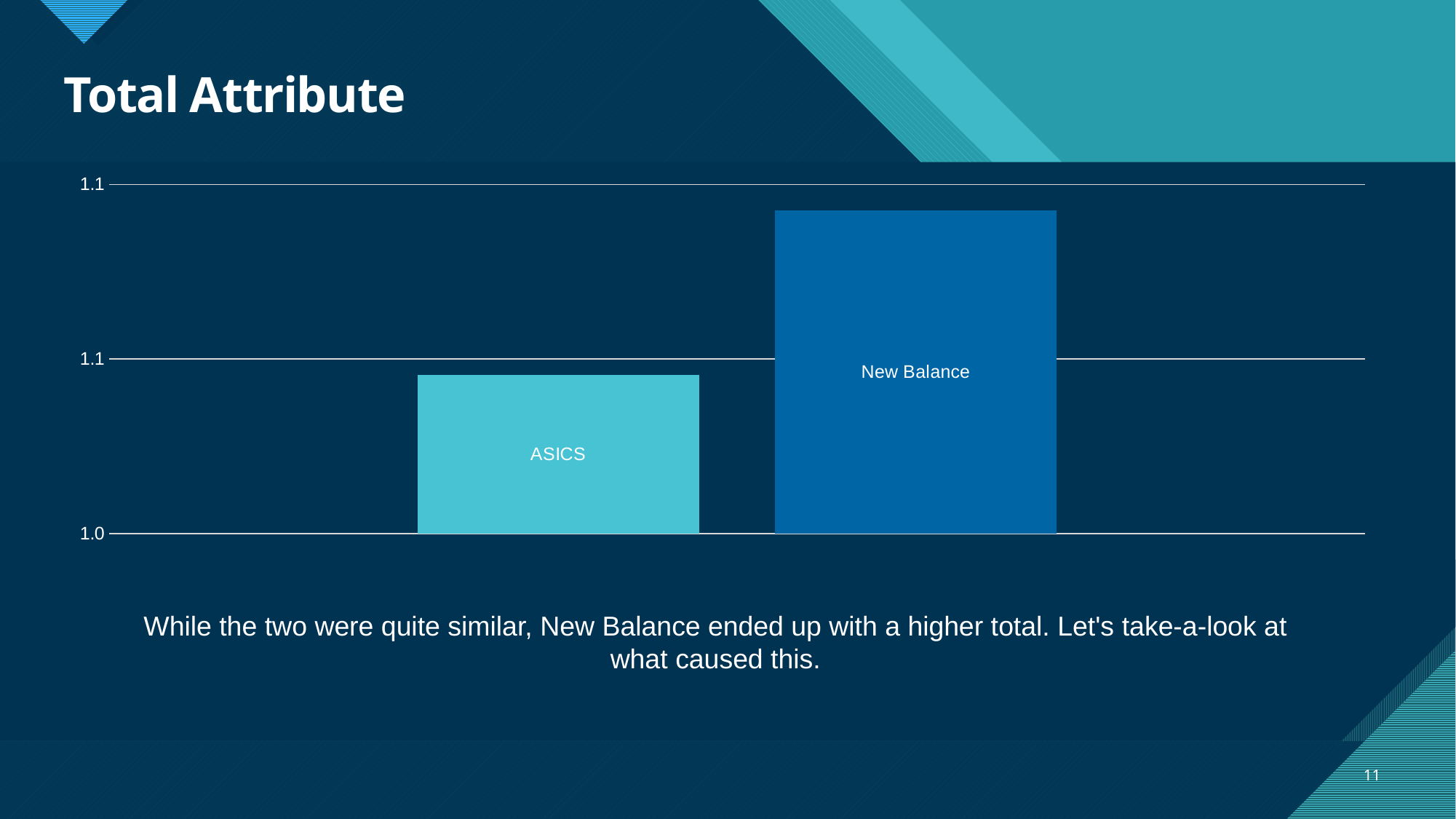
What kind of chart is shown on the slide? bar chart Do the bar values rise or fall moving from ASICS to New Balance along the x axis? rise Is the value for New Balance greater or less than 1.0? greater What is the lowest value labelled on the chart's vertical axis? 1.0 Which category has the highest value in the chart? New Balance Is the value for ASICS greater or less than 1.0? greater Which is larger, the value for ASICS or the value for New Balance? New Balance How many bars are plotted in the chart? 2 What is the title of the slide containing the chart? Total Attribute Which category has the lowest value in the chart? ASICS